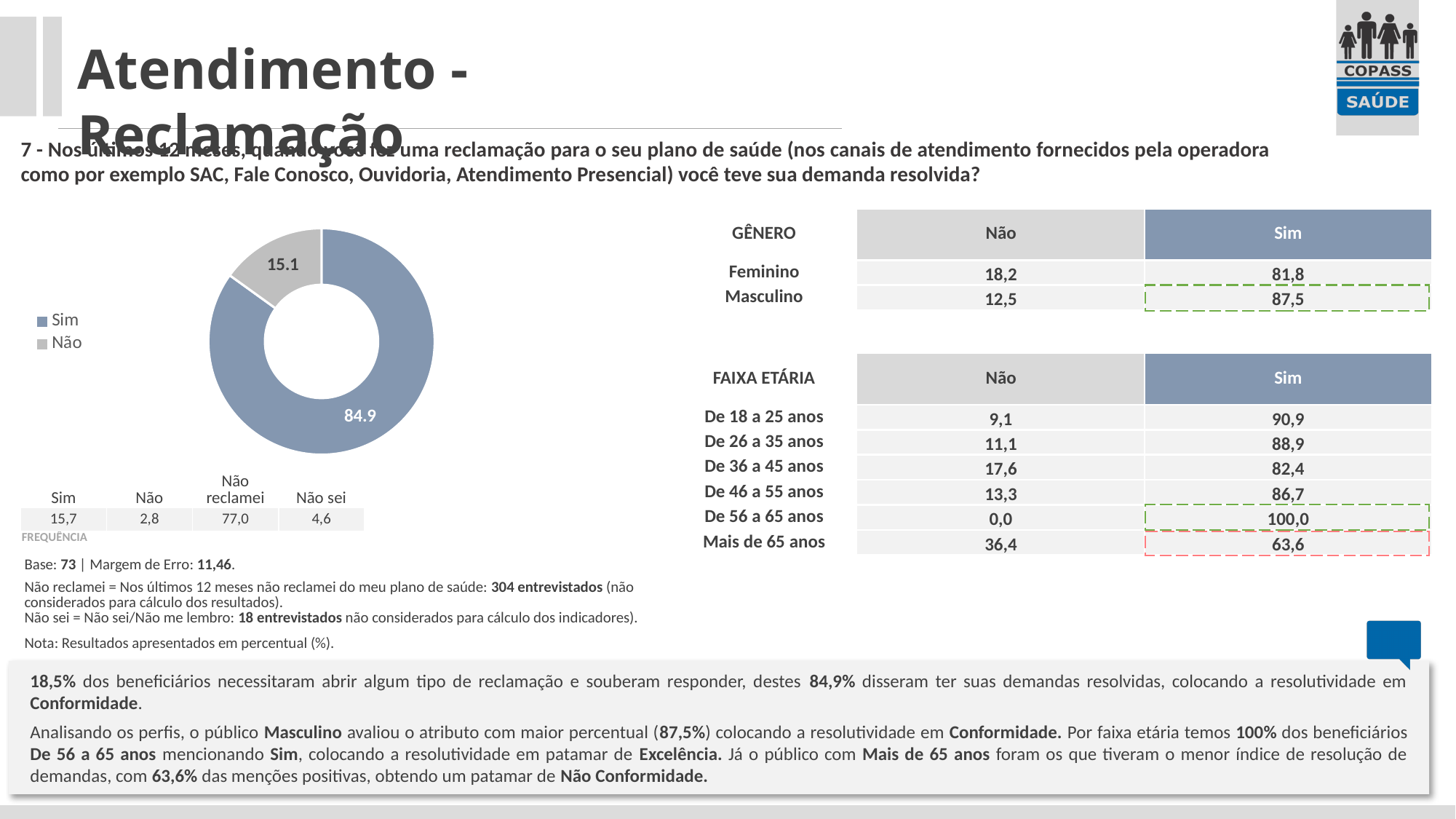
What is the difference between the "Sim" and "Não" values in the donut chart? 69.8 How many slices does the donut chart have? 2 How many entries does the legend of the donut chart list? 2 What is the value shown for the "Sim" slice of the donut chart? 84.9 What colour is the "Não" slice in the donut chart? Grey Which is larger in the donut chart, "Sim" or "Não"? Sim What kind of chart is shown on the slide? Donut (pie) chart What is the total of the two slice values shown in the donut chart? 100 What is the value shown for the "Não" slice of the donut chart? 15.1 Which slice of the donut chart is the largest? Sim What colour is the "Sim" slice in the donut chart? Blue Which slice of the donut chart is the smallest? Não